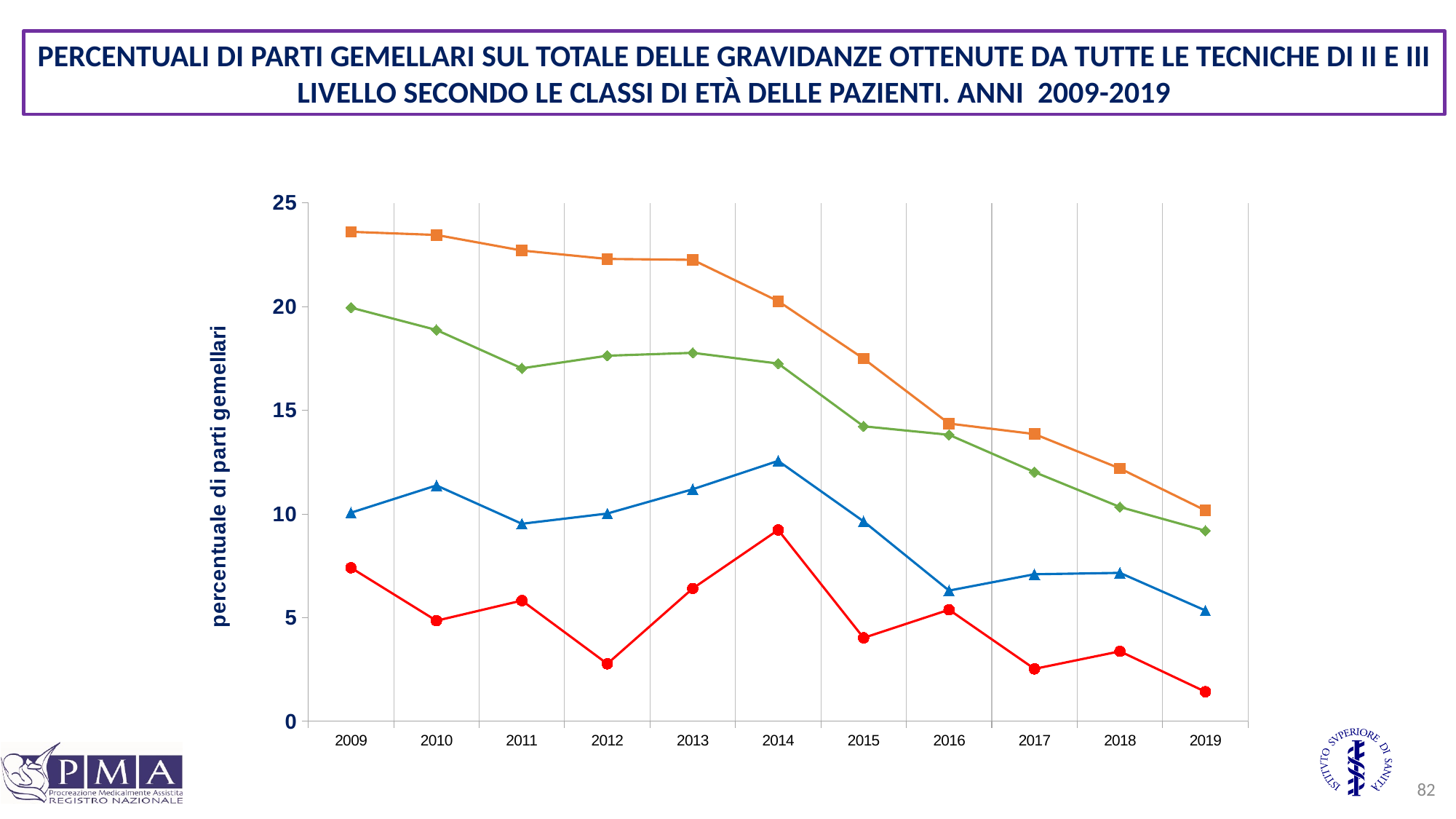
What is the label of the y axis? percentuale di parti gemellari In which year does the red line with circle markers reach its highest value? 2014 In which year does the red line with circle markers reach its lowest value? 2019 How many years are shown along the x axis? 11 In which year does the orange line with square markers reach its highest value? 2009 In 2009, which is larger: the value of the orange line with square markers or the green line with diamond markers? orange line with square markers Does the orange line with square markers rise or fall from 2009 to 2019? fall What kind of chart is shown on the slide? line chart Is the value of the orange line with square markers in 2009 greater or less than 20? greater How many data series (lines) are plotted on the chart? 4 Is the value of the blue line with triangle markers in 2014 greater or less than 10? greater Is the value of the red line with circle markers in 2012 greater or less than 5? less